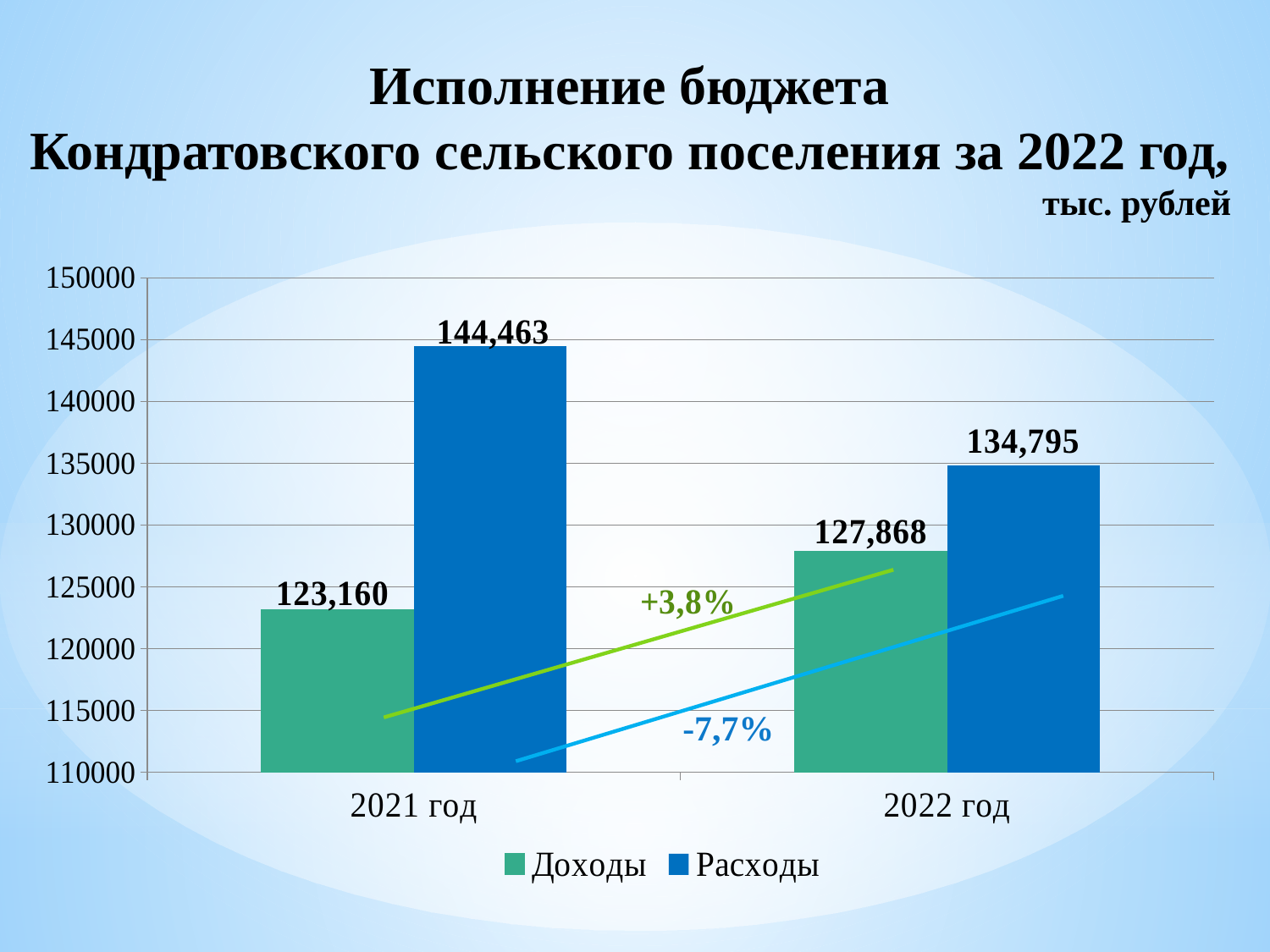
What is the value for Расходы in 2021 год? 144,463 What percentage change is shown on the green trend line for Доходы? +3,8% Which bar has the highest value on the chart? Расходы, 2021 год What is the value for Расходы in 2022 год? 134,795 What is the difference between Расходы and Доходы in 2022 год? 6,927 What is the value for Доходы in 2022 год? 127,868 Which is larger: Доходы in 2022 год or Доходы in 2021 год? Доходы in 2022 год Which bar has the lowest value on the chart? Доходы, 2021 год What is the value for Доходы in 2021 год? 123,160 What is the difference between Расходы and Доходы in 2021 год? 21,303 What kind of chart is shown on the slide? Bar chart How many series does the legend list? 2